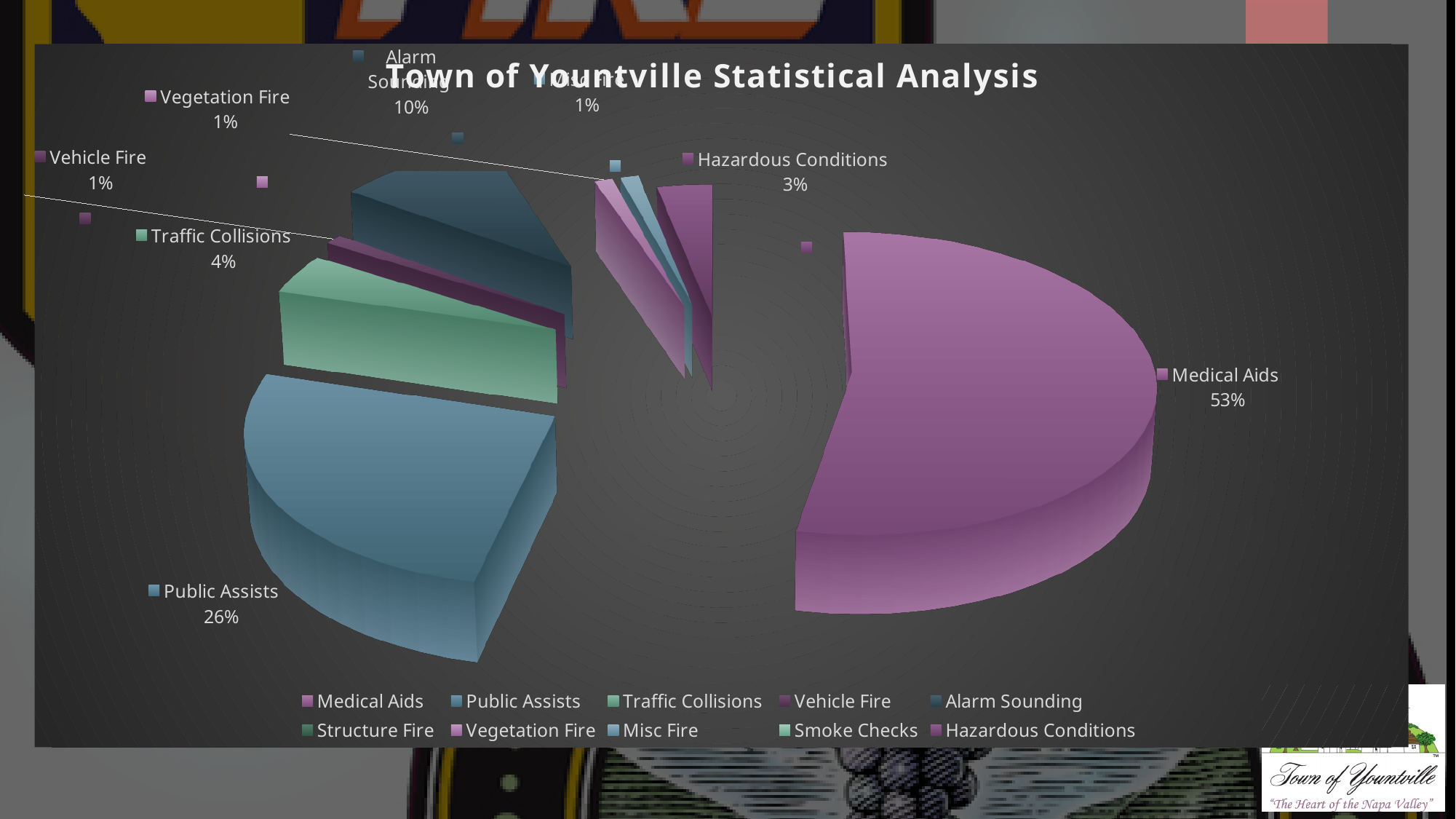
Which is larger, the share for Public Assists or the share for Alarm Sounding? Public Assists What percentage of the pie is Medical Aids? 53% What kind of chart is shown on the slide? Pie chart What percentage of the pie is Hazardous Conditions? 3% What percentage of the pie is Alarm Sounding? 10% How many categories does the legend list? 10 What is the difference in percentage points between Medical Aids and Public Assists? 27% What is the title of the chart? Town of Yountville Statistical Analysis What is the difference in percentage points between Alarm Sounding and Traffic Collisions? 6% What percentage of the pie is Public Assists? 26% Which category has the largest share of the pie? Medical Aids What percentage of the pie is Traffic Collisions? 4%